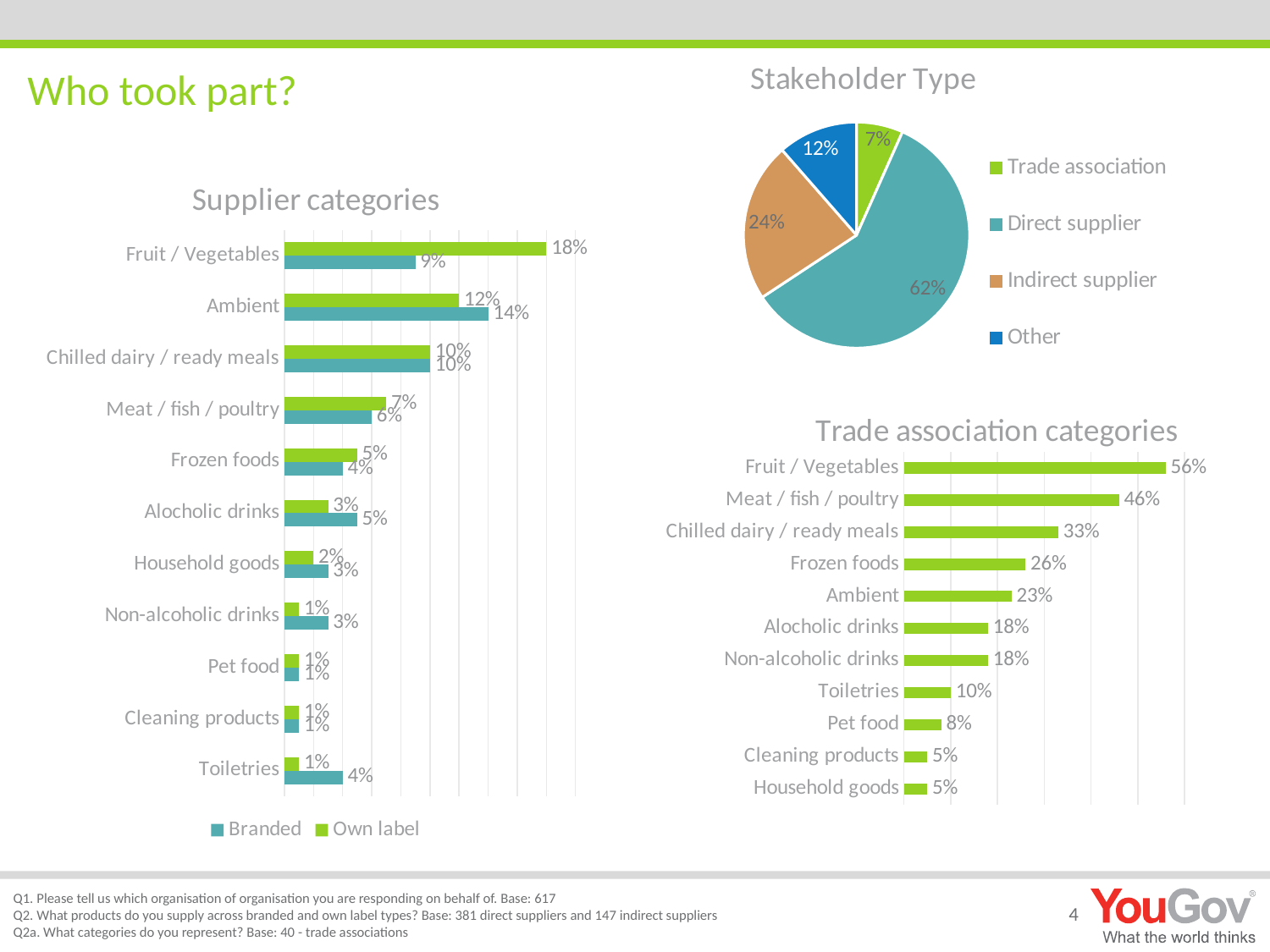
In the Trade association categories chart, which category has the highest value? Fruit / Vegetables In the Supplier categories chart, what is the Own label value for Fruit / Vegetables? 18% In the Trade association categories chart, how many categories are shown? 11 What type of chart is the Trade association categories chart? Bar chart In the Supplier categories chart, what is the Branded value for Ambient? 14% In the Stakeholder Type pie chart, how many slices are there? 4 In the Supplier categories chart, how many series does the legend list? 2 In the Supplier categories chart, what is the difference between the Own label and Branded values for Fruit / Vegetables? 9% In the Stakeholder Type pie chart, what share is Direct supplier? 62% In the Stakeholder Type pie chart, which stakeholder type has the smallest share? Trade association In the Supplier categories chart, which is larger for Toiletries, Branded or Own label? Branded In the Trade association categories chart, what is the value for Frozen foods? 26%